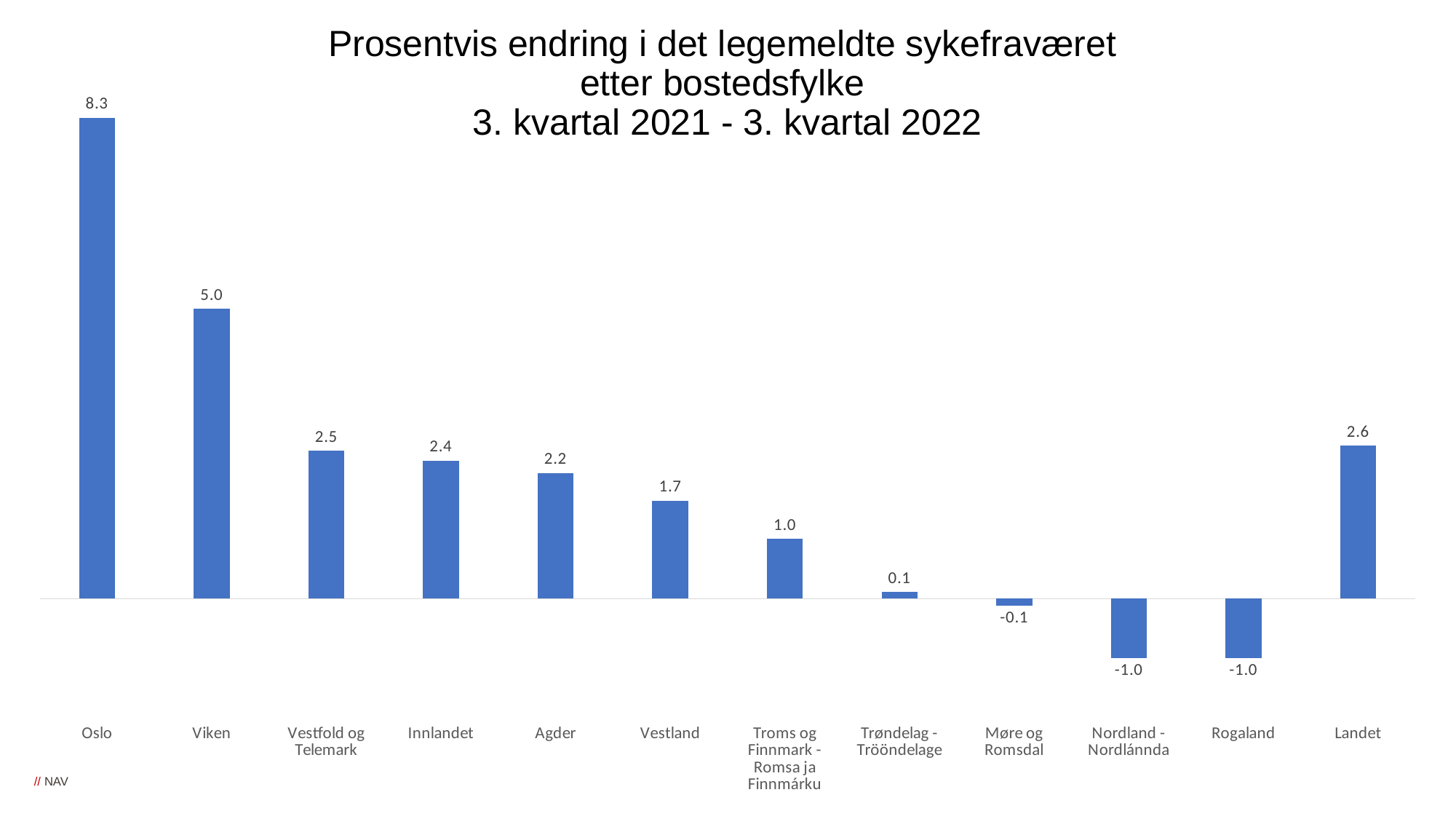
What kind of chart is this? Bar chart What is the value for Vestland? 1.7 What is the value for Landet? 2.6 What is the value for Oslo? 8.3 Which is larger, the value for Landet or the value for Vestfold og Telemark? Landet Which county has the highest value? Oslo What is the difference between the values for Vestfold og Telemark and Innlandet? 0.1 What is the value for Troms og Finnmark - Romsa ja Finnmárku? 1.0 How many categories are shown on the x axis? 12 What is the value for Møre og Romsdal? -0.1 What is the difference between the values for Oslo and Viken? 3.3 Which is larger, the value for Agder or the value for Vestland? Agder